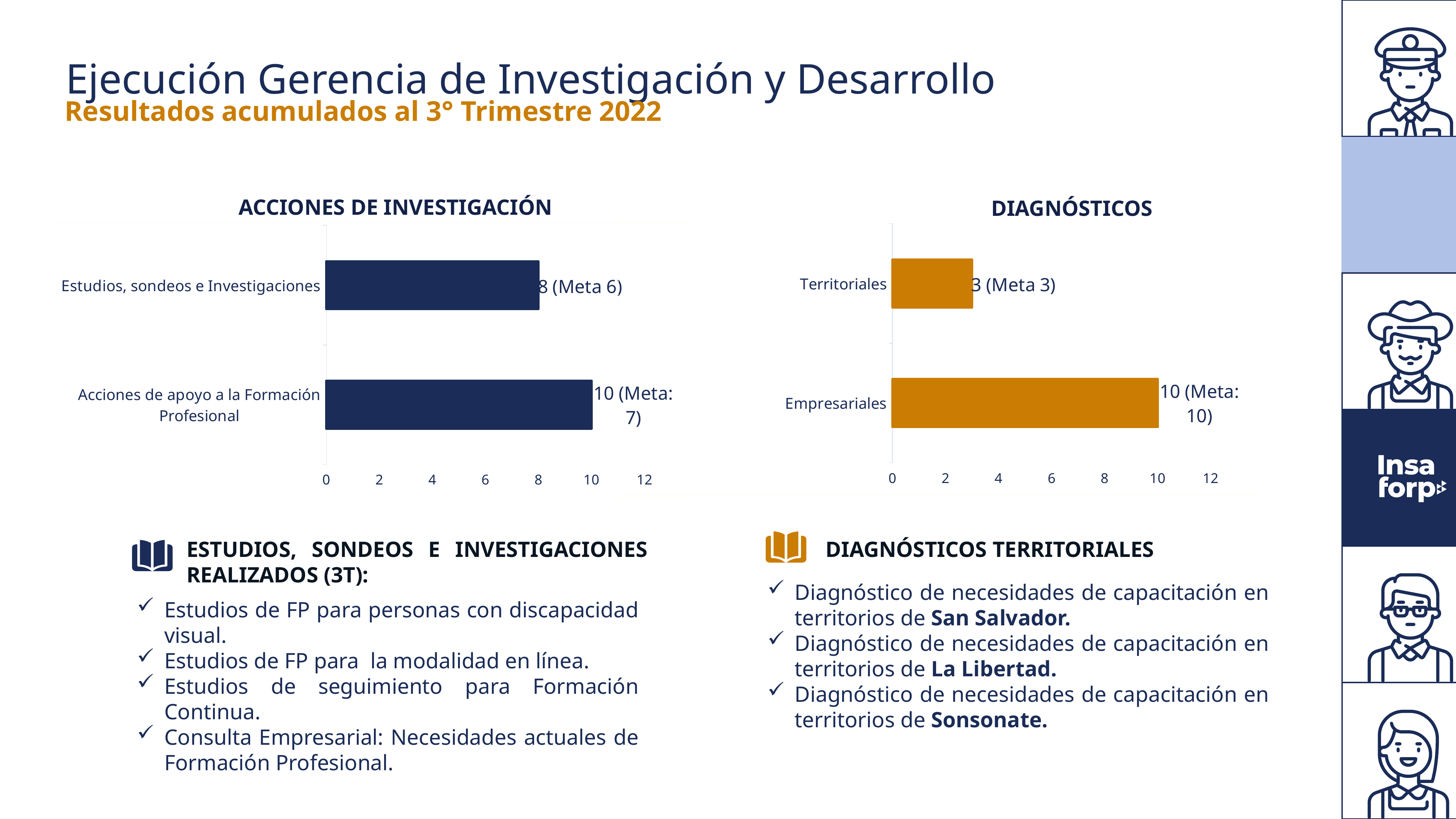
In the DIAGNÓSTICOS chart, is the value for Territoriales greater or less than 4? less In the DIAGNÓSTICOS chart, what is the value for Territoriales? 3 In the DIAGNÓSTICOS chart, what is the value for Empresariales? 10 In the DIAGNÓSTICOS chart, what is the difference between the Empresariales and Territoriales values? 7 In the ACCIONES DE INVESTIGACIÓN chart, what is the meta (target) shown for Estudios, sondeos e Investigaciones? 6 How many categories does the DIAGNÓSTICOS chart show? 2 In the ACCIONES DE INVESTIGACIÓN chart, what is the difference between the Acciones de apoyo a la Formación Profesional value and the Estudios, sondeos e Investigaciones value? 2 In the ACCIONES DE INVESTIGACIÓN chart, what is the value for Estudios, sondeos e Investigaciones? 8 In the ACCIONES DE INVESTIGACIÓN chart, which category has the lowest value? Estudios, sondeos e Investigaciones What type of chart is the ACCIONES DE INVESTIGACIÓN chart? Bar chart In the DIAGNÓSTICOS chart, which category has the highest value? Empresariales In the ACCIONES DE INVESTIGACIÓN chart, what is the value for Acciones de apoyo a la Formación Profesional? 10